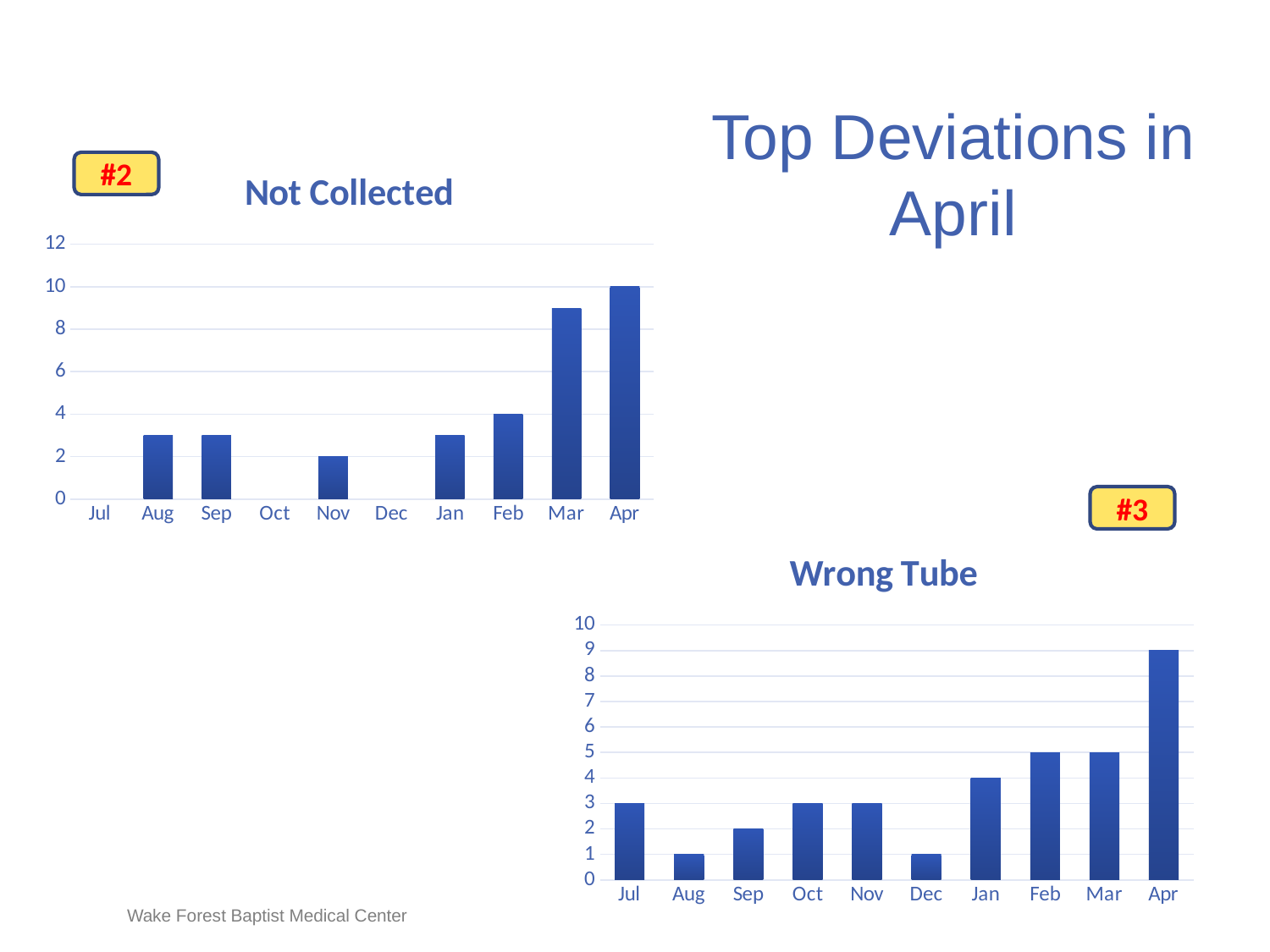
In the Wrong Tube chart, which is larger, the value for Jul or the value for Aug? Jul In the Not Collected chart, is the value for Mar greater or less than 8? greater What kind of chart is the Not Collected chart? Bar chart In the Wrong Tube chart, which month has the highest value? Apr How many months are shown on the x axis of the Wrong Tube chart? 10 In the Wrong Tube chart, what is the value for Jan? 4 In the Not Collected chart, which month has the highest value? Apr In the Not Collected chart, what is the value for Feb? 4 In the Not Collected chart, what is the value for Apr? 10 In the Not Collected chart, is the value for Aug greater or less than 4? less In the Wrong Tube chart, what is the value for Apr? 9 In the Wrong Tube chart, what is the difference between the values for Apr and Feb? 4